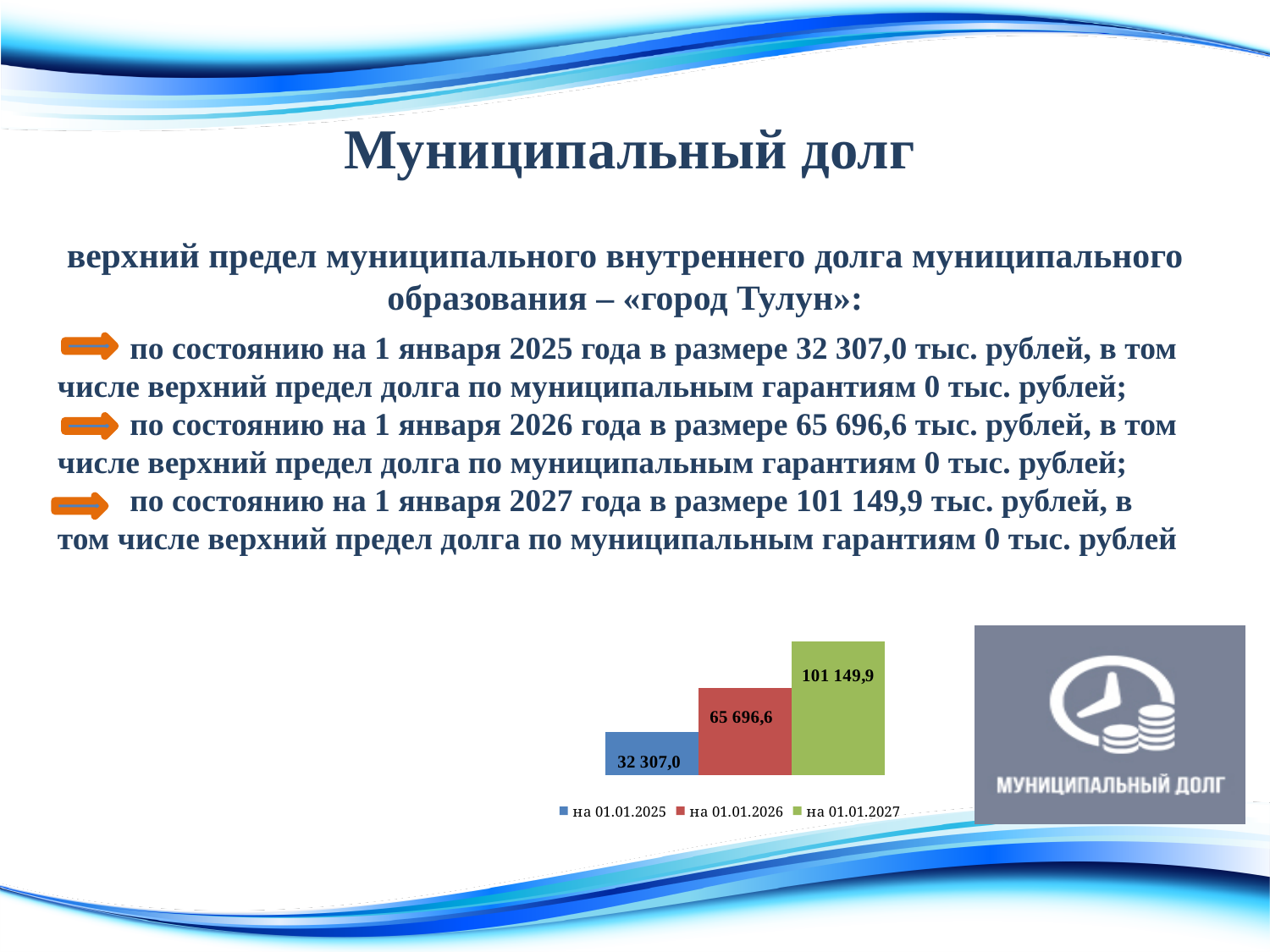
How many bars are plotted in the chart? 3 What is the value shown for на 01.01.2027? 101 149,9 Which legend entry has the lowest value? на 01.01.2025 Do the values rise or fall from на 01.01.2025 to на 01.01.2027? rise What is the difference between the values for на 01.01.2027 and на 01.01.2026? 35 453,3 How many entries does the chart legend list? 3 Which is larger, the value for на 01.01.2026 or the value for на 01.01.2027? на 01.01.2027 Which legend entry has the highest value? на 01.01.2027 What is the difference between the values for на 01.01.2026 and на 01.01.2025? 33 389,6 What is the value shown for на 01.01.2026? 65 696,6 What kind of chart is shown on the slide? bar chart What is the value shown for на 01.01.2025? 32 307,0